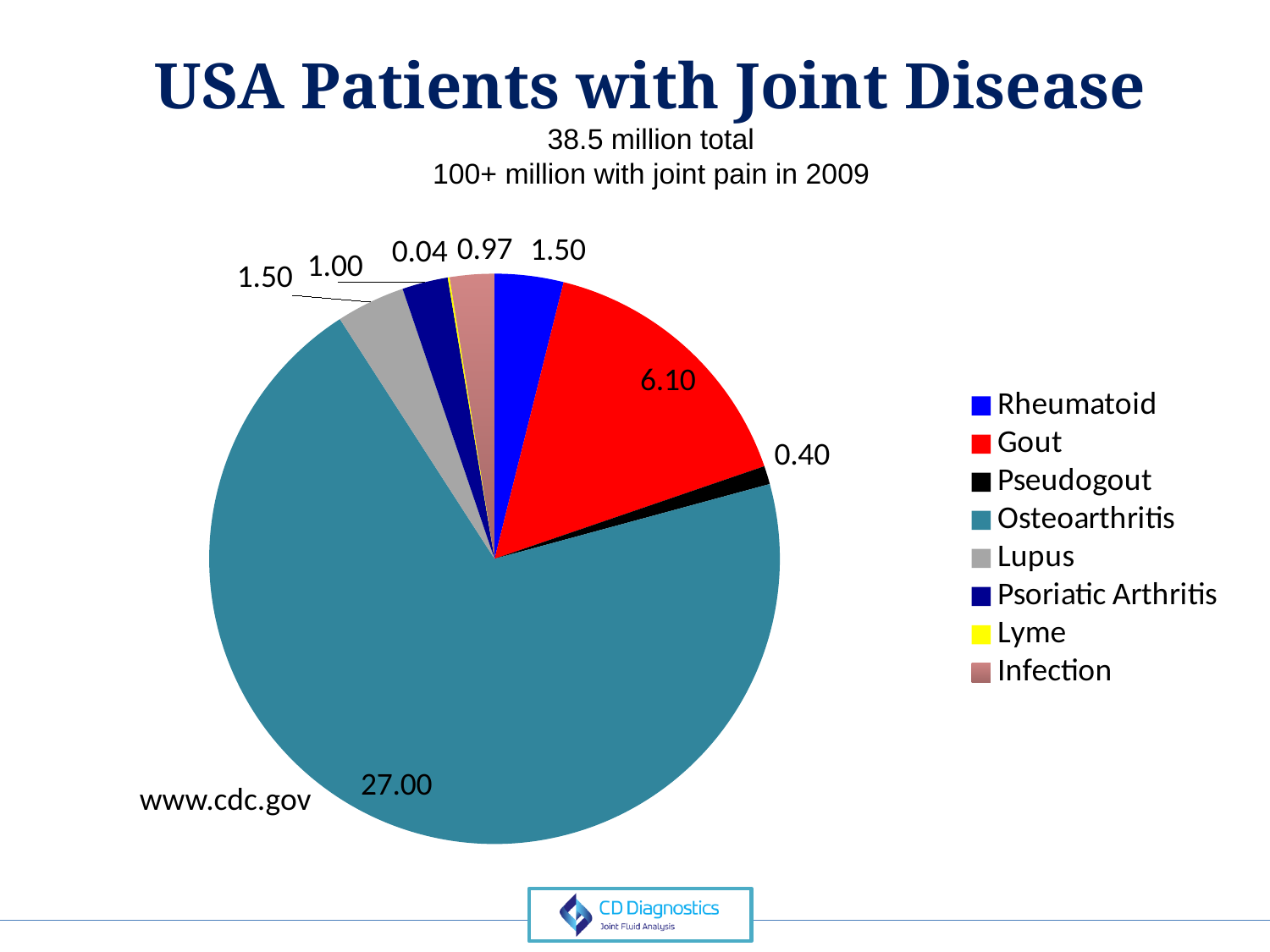
What is the difference between the Gout value and the Rheumatoid value? 4.60 What value is shown for the Pseudogout slice? 0.40 What value is shown for the Osteoarthritis slice? 27.00 What value is shown for the Gout slice? 6.10 Which category has the largest slice of the pie? Osteoarthritis What value is shown for the Infection slice? 0.97 Which category has the smallest slice of the pie? Lyme What kind of chart is shown on the slide? Pie chart What value is shown for the Lyme slice? 0.04 What colour is the Gout slice in the pie chart? Red How many categories does the pie chart show? 8 Which is larger, the Psoriatic Arthritis slice or the Lupus slice? Lupus